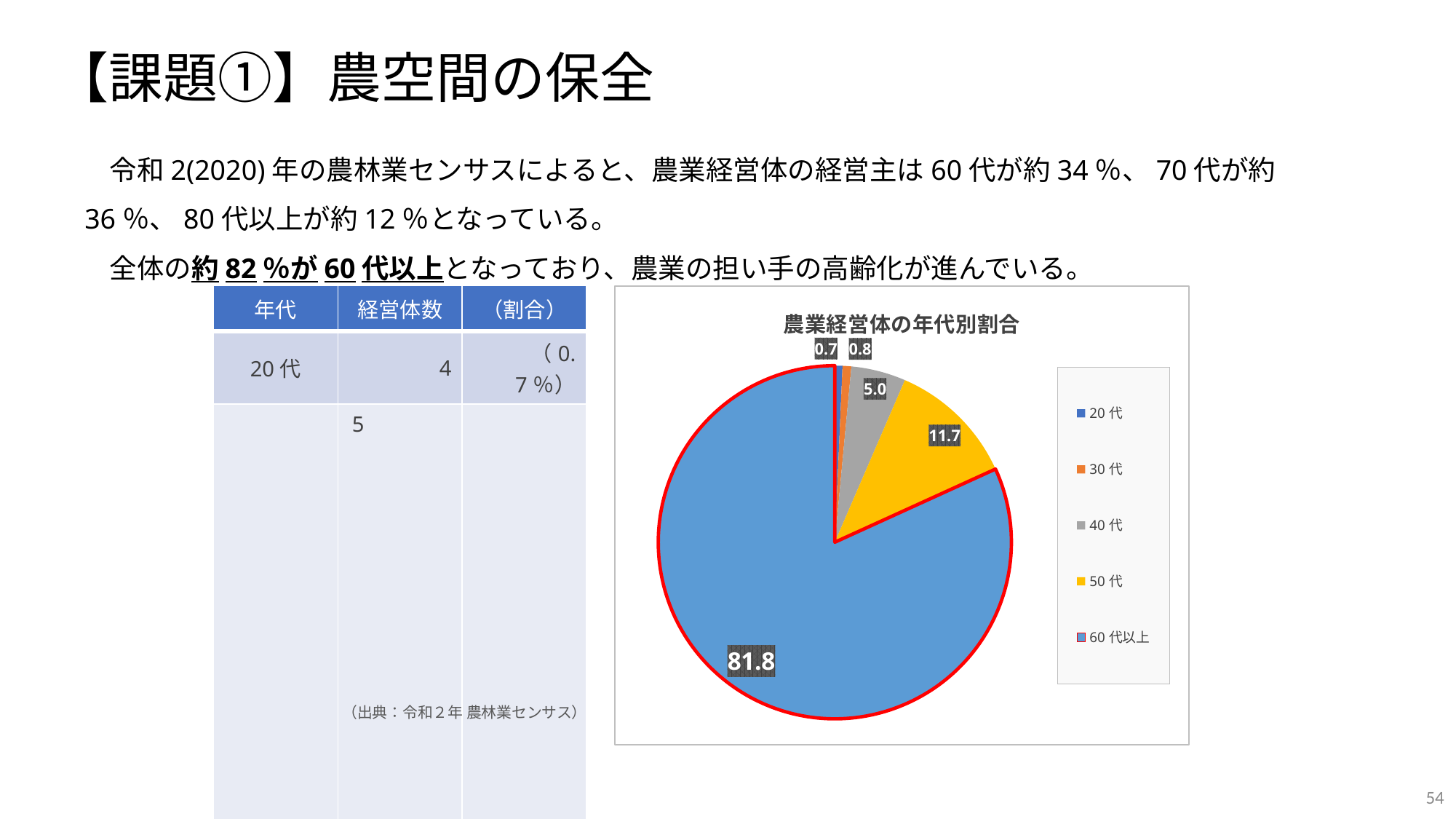
What is the value shown for 40代 in the pie chart? 5.0 What is the value shown for 60代以上 in the pie chart? 81.8 How many slices does the pie chart have? 5 Which age group has the largest slice in the pie chart? 60代以上 Which age group has the smallest slice in the pie chart? 20代 How many entries does the legend of the pie chart list? 5 What is the difference between the values for 60代以上 and 50代 in the pie chart? 70.1 What is the value shown for 50代 in the pie chart? 11.7 What type of chart is shown on the slide? Pie chart What is the title of the pie chart? 農業経営体の年代別割合 What is the value shown for 30代 in the pie chart? 0.8 Which is larger in the pie chart, the value for 40代 or the value for 50代? 50代